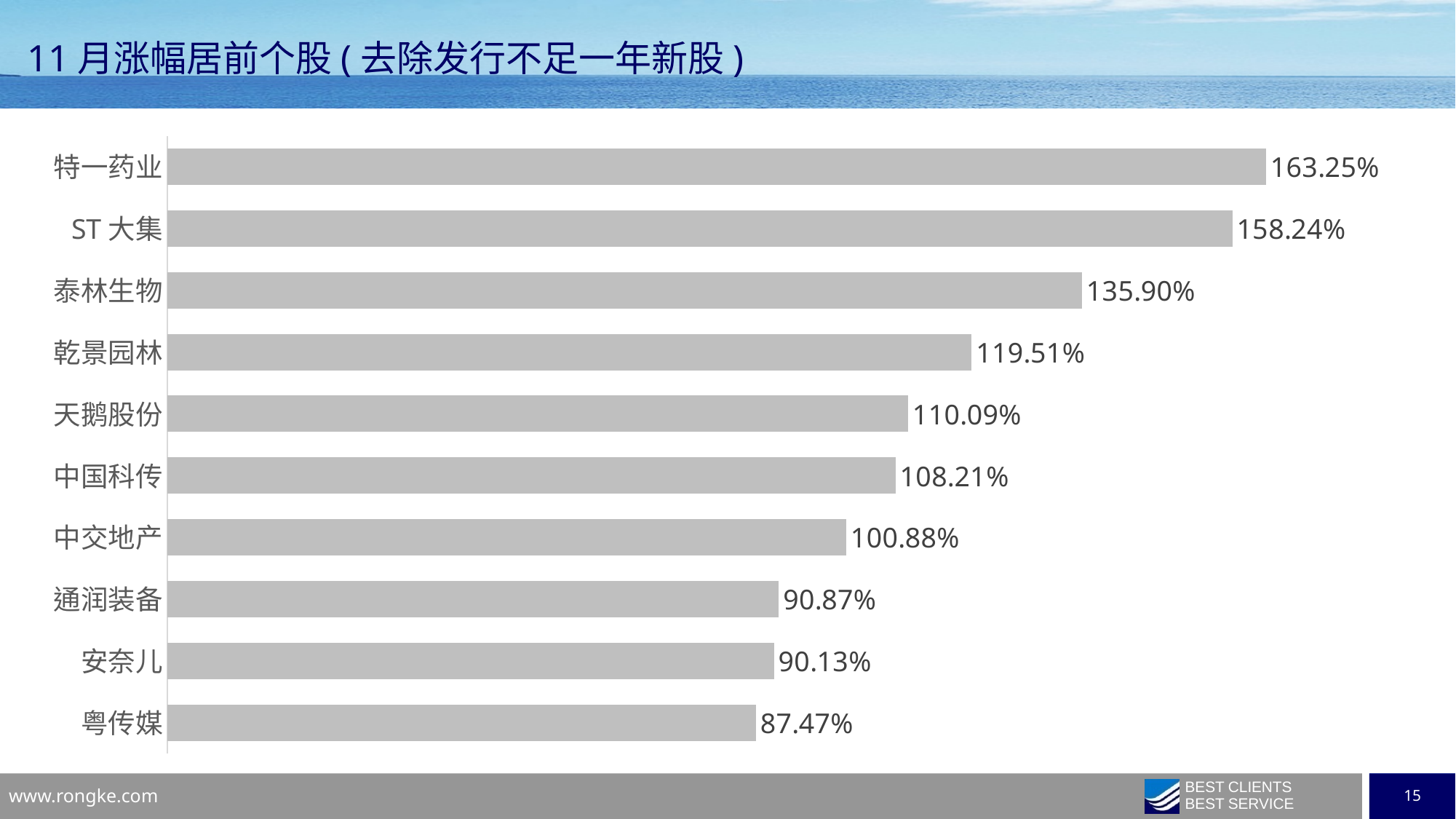
What is the title of the slide? 11月涨幅居前个股（去除发行不足一年新股） What is the difference between the values for 泰林生物 and 粤传媒? 48.43% Which is larger, the value for 中交地产 or the value for 通润装备? 中交地产 Which stock has the lowest value? 粤传媒 Which is larger, the value for 天鹅股份 or the value for 中国科传? 天鹅股份 What is the value for 特一药业? 163.25% Which stock has the highest value? 特一药业 What is the difference between the values for 特一药业 and ST大集? 5.01% What kind of chart is shown on the slide? Bar chart What is the value for 安奈儿? 90.13% How many stocks are shown in the chart? 10 What is the value for 乾景园林? 119.51%